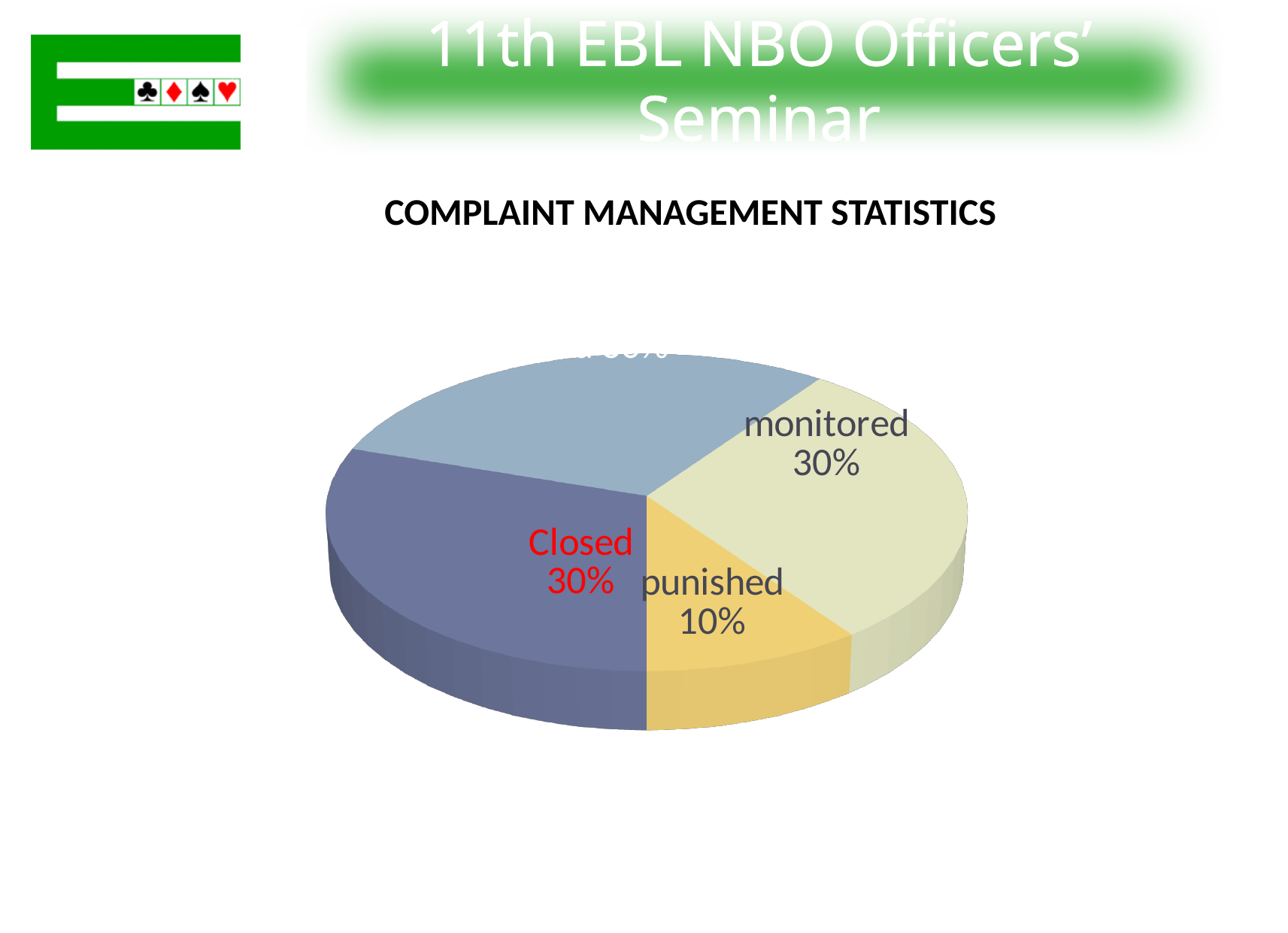
What is the difference between the "Closed" share and the "punished" share? 20% Which slice of the pie is the smallest? punished Do the "monitored" and "Closed" slices have the same percentage? yes How many slices does the pie chart have? 4 What kind of chart is shown on the slide? pie chart What share of the pie does the "punished" slice represent? 10% What percentage of the pie is labelled "Closed"? 30% What is the title of the chart? COMPLAINT MANAGEMENT STATISTICS Which slice label is written in red text? Closed What percentage of the pie is labelled "monitored"? 30% Which is larger, the "monitored" slice or the "punished" slice? monitored What percentage of the pie is labelled "punished"? 10%